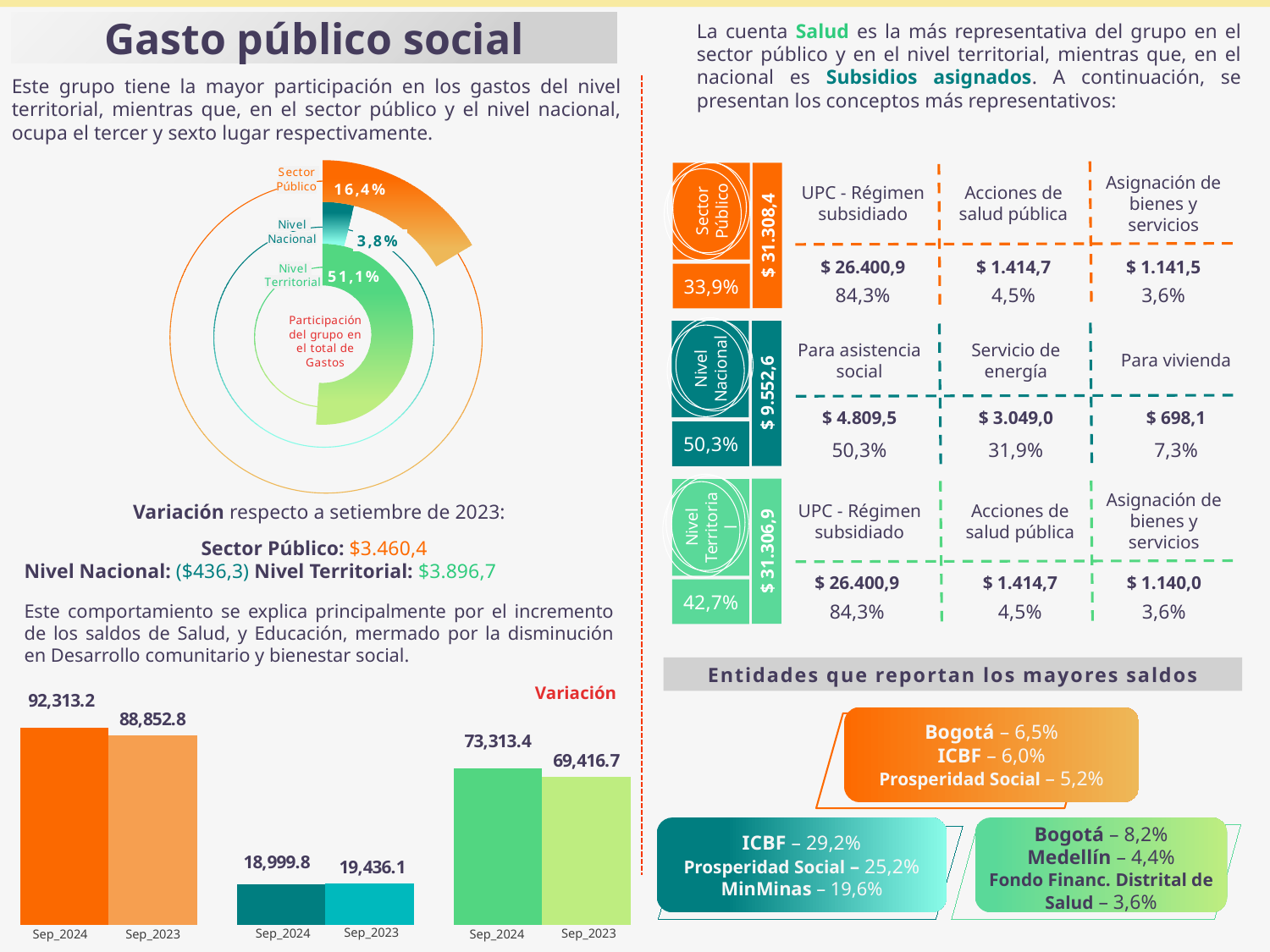
In the radial chart 'Participación del grupo en el total de Gastos', which category has the highest value? Nivel Territorial In the radial chart 'Participación del grupo en el total de Gastos', how many categories are shown? 3 In the bar chart at the bottom left, what is the value of the Sep_2024 bar in the rightmost (green) group? 73,313.4 In the radial chart 'Participación del grupo en el total de Gastos', what is the value for Nivel Nacional? 3,8% In the bar chart at the bottom left, which bar is the highest overall? Sep_2024 in the leftmost (orange) group, 92,313.2 In the radial chart 'Participación del grupo en el total de Gastos', what is the value for Sector Público? 16,4% In the bar chart at the bottom left, what is the value of the orange Sep_2024 bar in the leftmost group? 92,313.2 In the bar chart at the bottom left, what is the difference between the Sep_2024 and Sep_2023 bars in the leftmost (orange) group? 3,460.4 In the bar chart at the bottom left, what is the value of the Sep_2023 bar in the middle (teal) group? 19,436.1 What type of chart is shown at the bottom left of the slide? Bar chart In the radial chart 'Participación del grupo en el total de Gastos', which category has the lowest value? Nivel Nacional In the bar chart at the bottom left, which is larger in the middle (teal) group: Sep_2024 or Sep_2023? Sep_2023